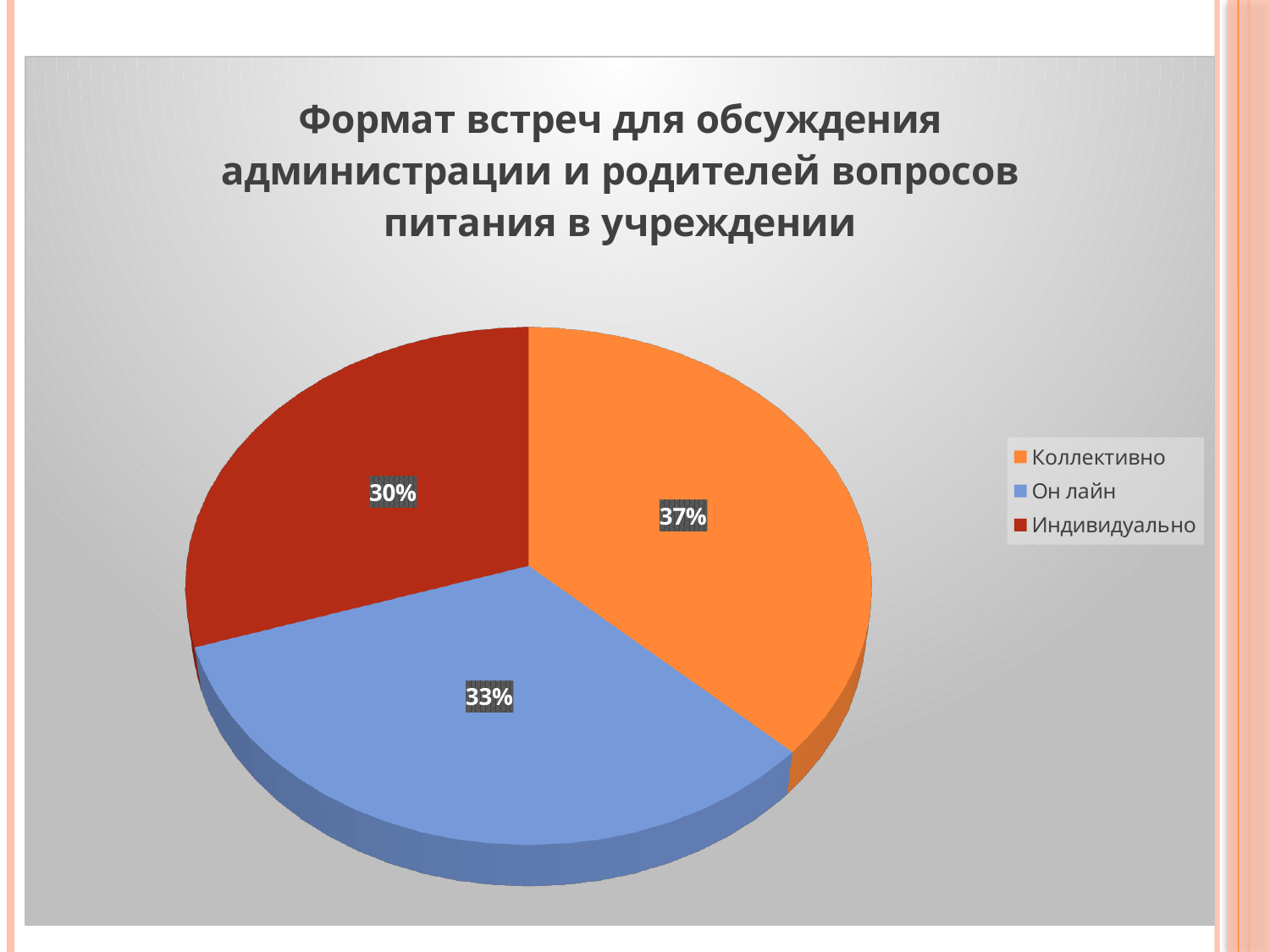
What share of the pie does Индивидуально have? 30% What share of the pie does Коллективно have? 37% What is the difference in percentage points between Коллективно and Индивидуально? 7 Which category has the smallest slice of the pie? Индивидуально Which legend entry is shown in red? Индивидуально What is the difference in percentage points between Он лайн and Индивидуально? 3 Which category has the largest slice of the pie? Коллективно What kind of chart is shown on the slide? Pie chart What share of the pie does Он лайн have? 33% Which is larger, the share for Коллективно or the share for Он лайн? Коллективно What colour is the slice for Он лайн? Blue How many categories does the pie chart show? 3